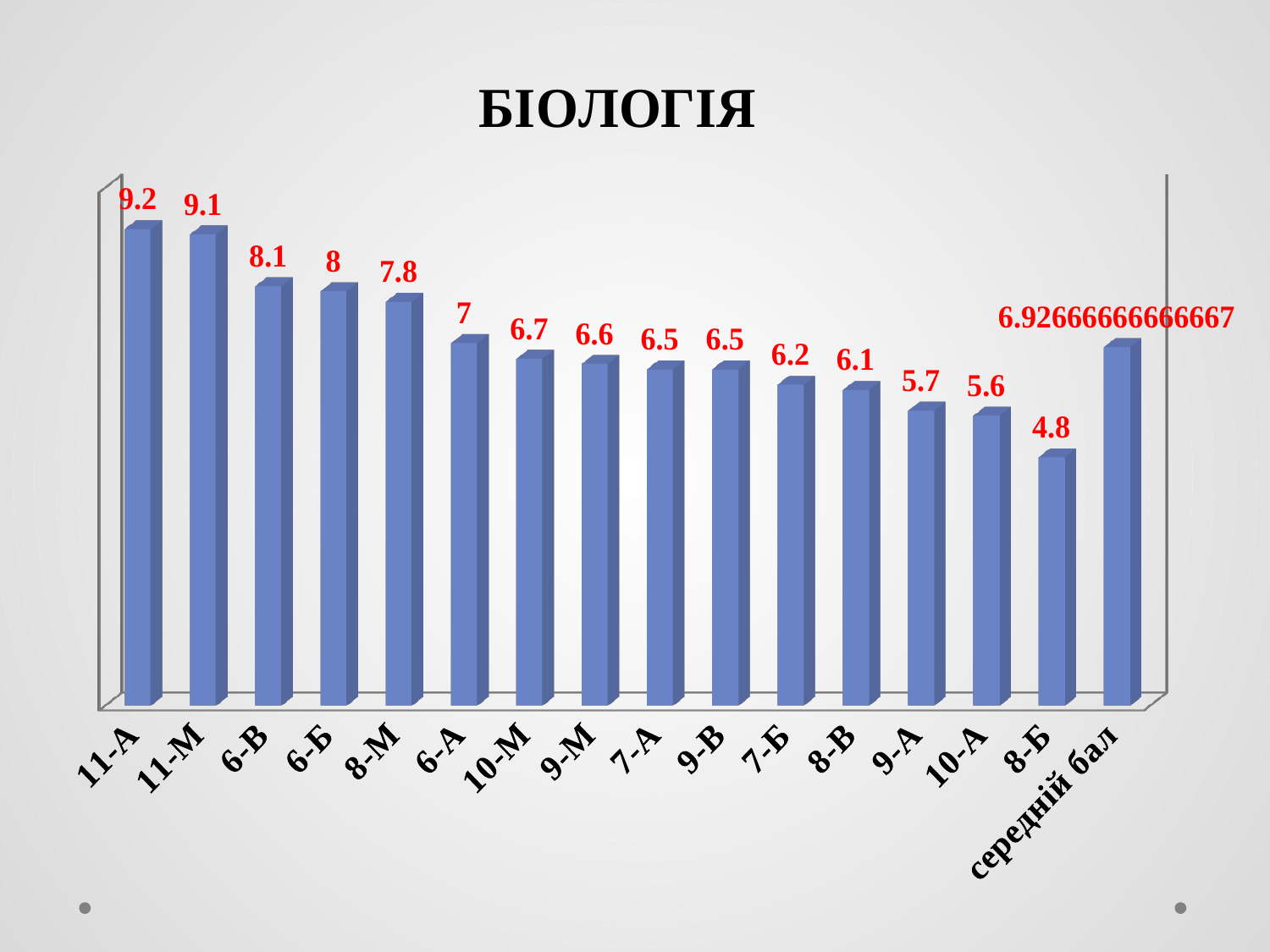
Which category has the highest value? 11-А What is the value for 8-Б? 4.8 What is the title of the chart? БІОЛОГІЯ Which category has the lowest value? 8-Б What is the difference between the values for 11-А and 8-Б? 4.4 What is the difference between the values for 6-В and 6-Б? 0.1 What value is shown for середній бал? 6.92666666666667 What is the value for 10-М? 6.7 Which is larger, the value for 8-М or the value for 9-А? 8-М What is the value for 11-А? 9.2 How many bars are plotted on the chart? 16 What kind of chart is shown on the slide? Bar chart